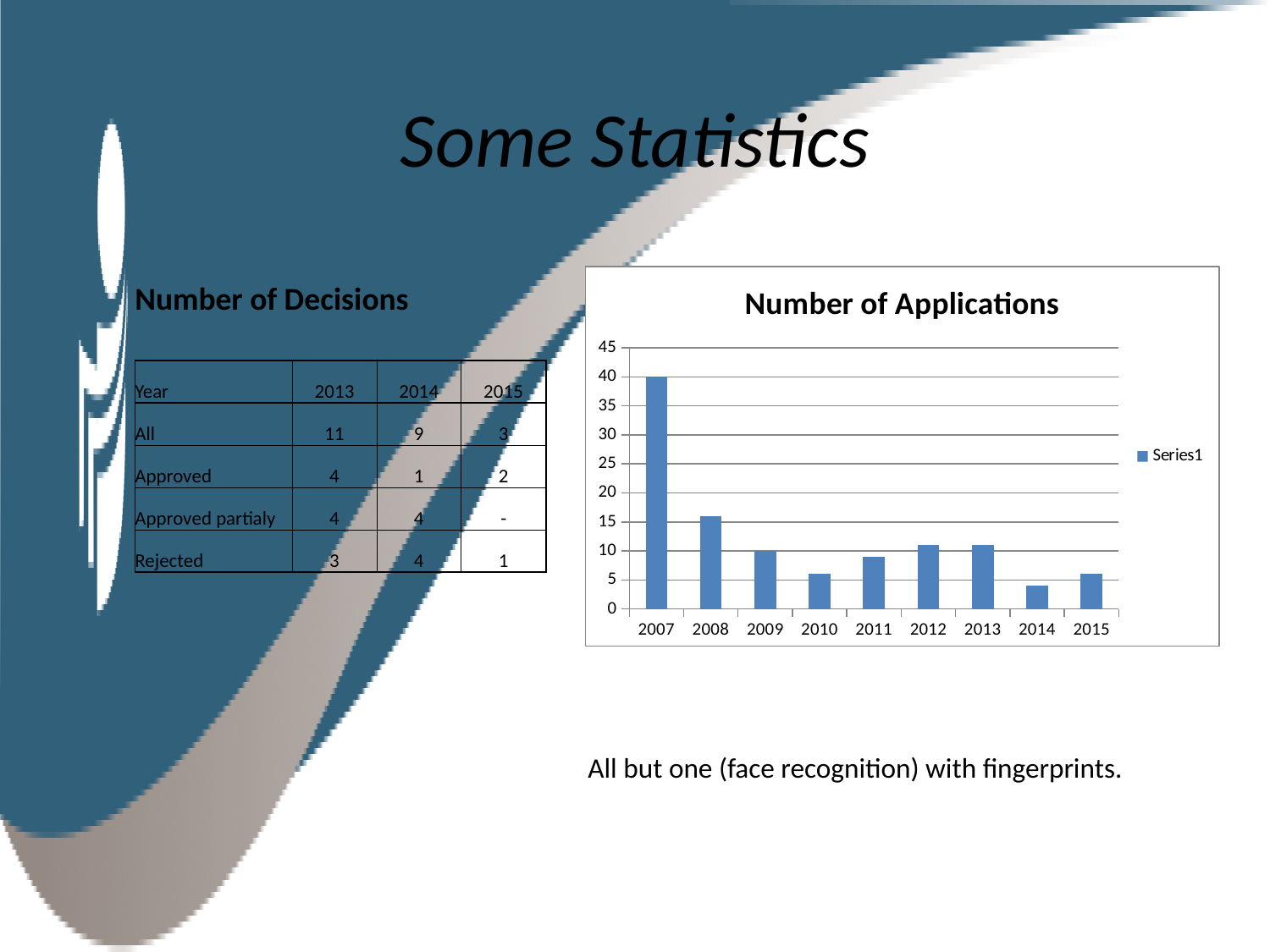
In the "Number of Applications" chart, which year has more applications, 2008 or 2009? 2008 In the "Number of Applications" chart, which year has the lowest number of applications? 2014 In the "Number of Applications" chart, which year has the highest number of applications? 2007 What kind of chart is the "Number of Applications" chart? bar chart How many years are shown on the x axis of the "Number of Applications" chart? 9 In the "Number of Applications" chart, is the value for 2008 greater or less than 10? greater In the "Number of Applications" chart, what is the value for 2009? 10 In the "Number of Applications" chart, is the value for 2014 greater or less than 5? less In the "Number of Applications" chart, what is the value for 2007? 40 What is the legend entry shown in the "Number of Applications" chart? Series1 In the "Number of Applications" chart, is the value for 2010 greater or less than 10? less How many series does the legend of the "Number of Applications" chart list? 1